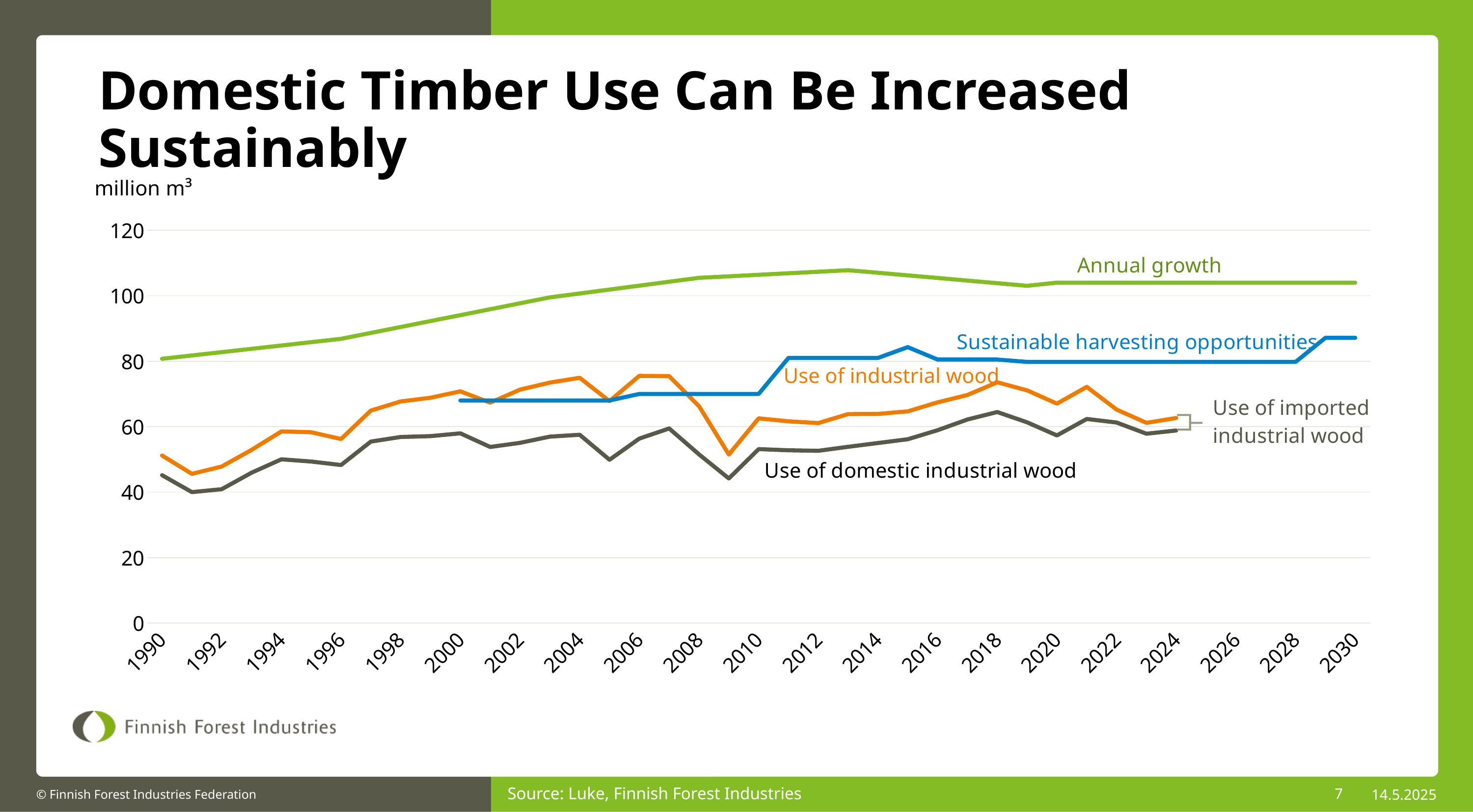
Does the 'Annual growth' line rise or fall from 1990 to 2014? rise Which series has the highest values across the whole chart? Annual growth Is the value for 'Use of domestic industrial wood' in 2018 greater or less than 60? greater What colour is the 'Annual growth' line? green Is the value for 'Sustainable harvesting opportunities' in 2000 greater or less than 80? less What kind of chart is shown on the slide? line chart In 2030, which is larger: 'Annual growth' or 'Sustainable harvesting opportunities'? Annual growth How many data series are plotted on the chart? 4 Is the value for 'Sustainable harvesting opportunities' in 2030 greater or less than 80? greater What unit is shown for the y axis of the chart? million m³